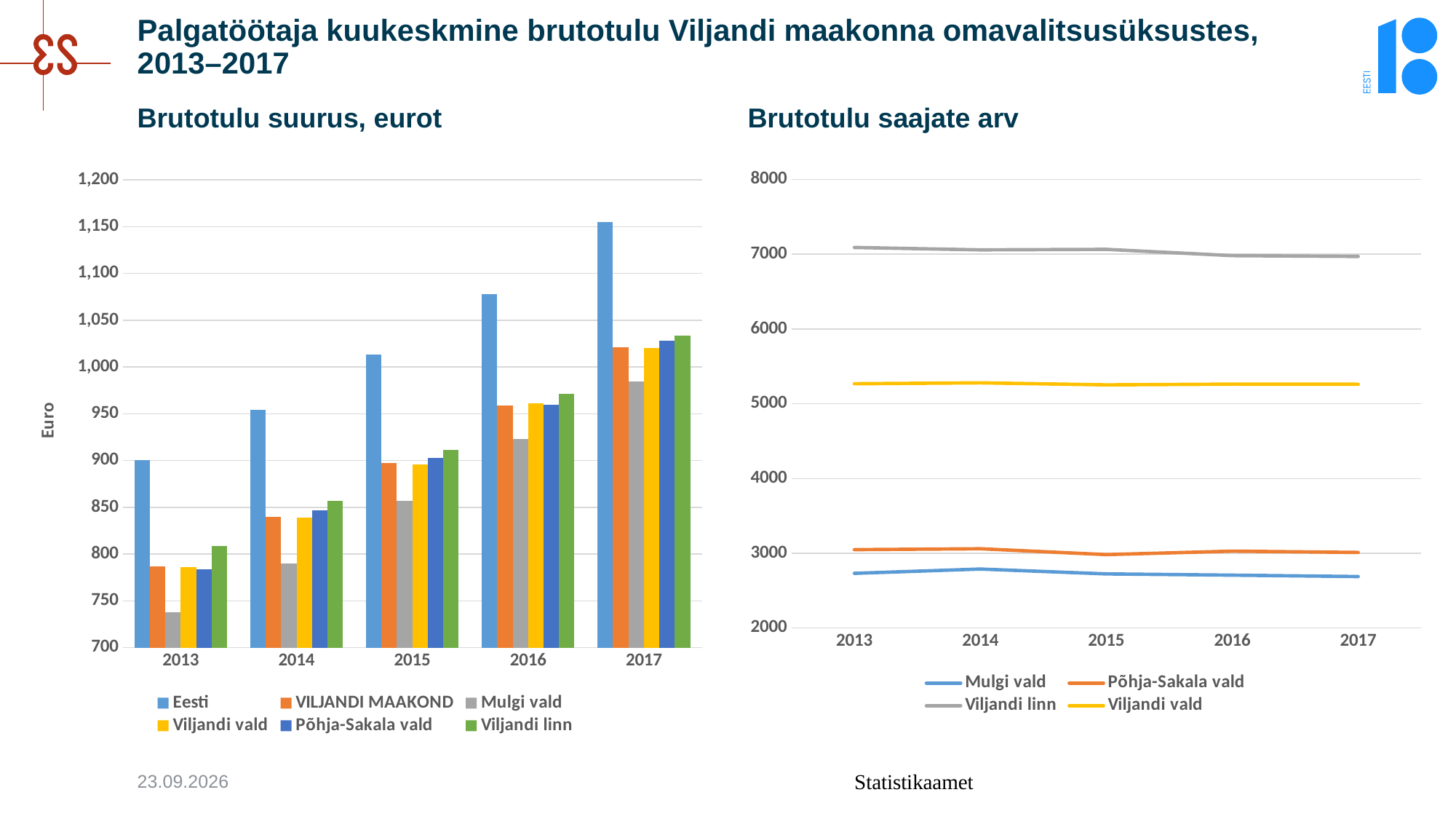
On the right chart 'Brutotulu saajate arv', which series has the highest values? Viljandi linn On the left chart 'Brutotulu suurus, eurot', do the Eesti values rise or fall from 2013 to 2017? rise On the left chart 'Brutotulu suurus, eurot', is the value for Eesti in 2017 greater or less than 1,100? greater On the left chart 'Brutotulu suurus, eurot', how many years are shown on the x axis? 5 On the left chart 'Brutotulu suurus, eurot', what kind of chart is shown? bar chart On the left chart 'Brutotulu suurus, eurot', how many series does the legend list? 6 On the left chart 'Brutotulu suurus, eurot', which series has the lowest bar in 2013? Mulgi vald On the left chart 'Brutotulu suurus, eurot', in which year is the Eesti bar highest? 2017 On the right chart 'Brutotulu saajate arv', is the value for Mulgi vald in 2017 greater or less than 3000? less On the left chart 'Brutotulu suurus, eurot', is the value for Mulgi vald in 2013 greater or less than 750? less On the right chart 'Brutotulu saajate arv', what kind of chart is shown? line chart On the right chart 'Brutotulu saajate arv', how many series does the legend list? 4